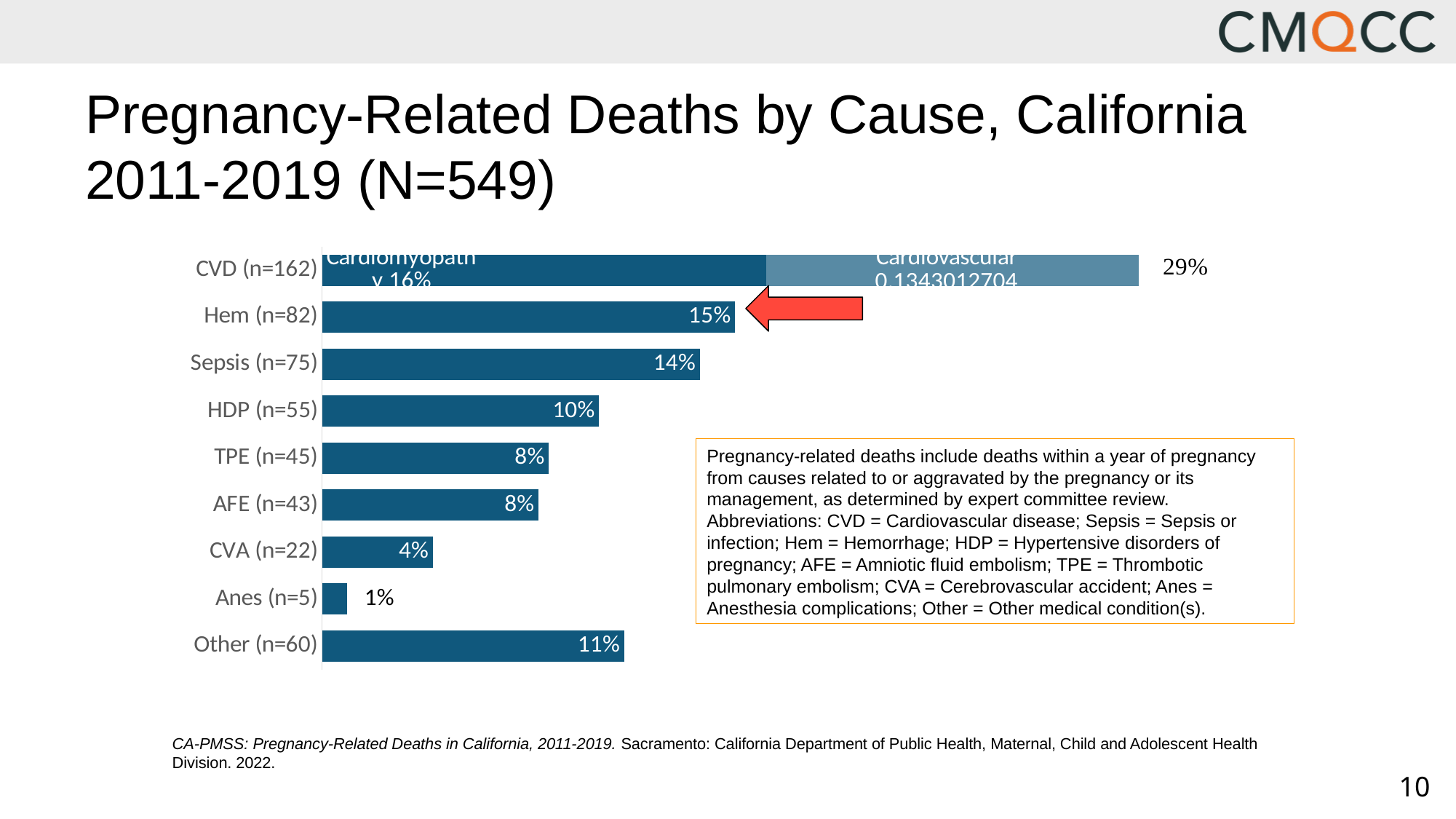
What percentage is shown for Other (n=60)? 11% What percentage is shown for Sepsis (n=75)? 14% What percentage is shown for Anes (n=5)? 1% What is the difference in percentage points between Hem (n=82) and HDP (n=55)? 5 What is the total percentage shown at the end of the CVD (n=162) bar? 29% What percentage of pregnancy-related deaths is shown for Hem (n=82)? 15% Which cause has the highest percentage of pregnancy-related deaths? CVD (n=162) Which cause has the lowest percentage of pregnancy-related deaths? Anes (n=5) How many cause categories are shown in the chart? 9 What kind of chart is shown on the slide? bar chart Which is larger, the percentage for Sepsis (n=75) or for Other (n=60)? Sepsis (n=75) What percentage is shown for HDP (n=55)? 10%